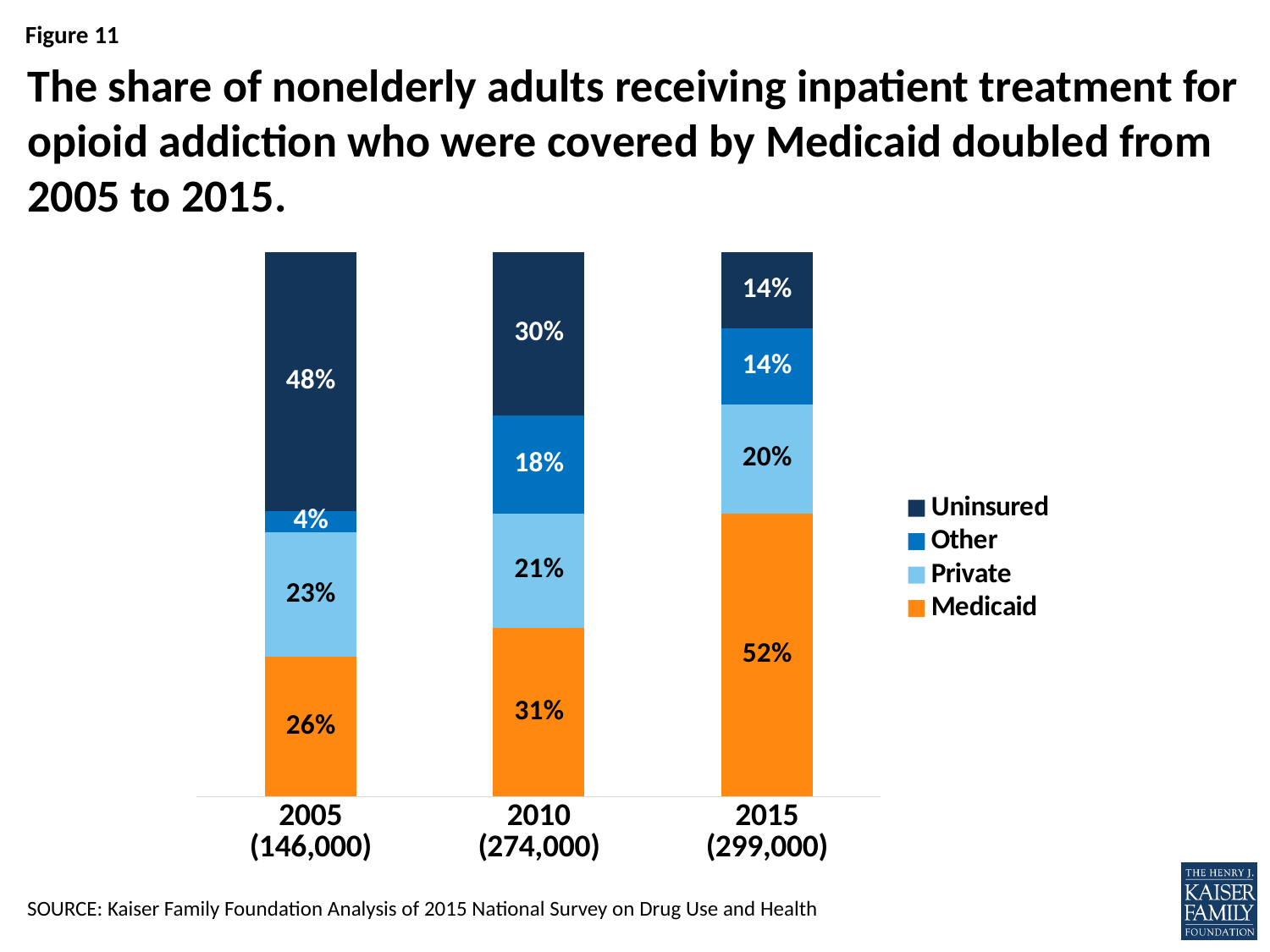
What is the Medicaid share for 2015? 52% How many series does the legend list? 4 In which year is the Medicaid share highest? 2015 What is the Uninsured share for 2005? 48% Which is larger, the Other share in 2010 or the Other share in 2015? 2010 In which year is the Uninsured share lowest? 2015 What is the difference between the Medicaid share in 2015 and in 2005? 26% What is the Private share for 2010? 21% What kind of chart is shown? Stacked bar chart Does the Uninsured share rise or fall from 2005 to 2015? Fall How many years are shown on the x axis? 3 What is the Other share for 2005? 4%